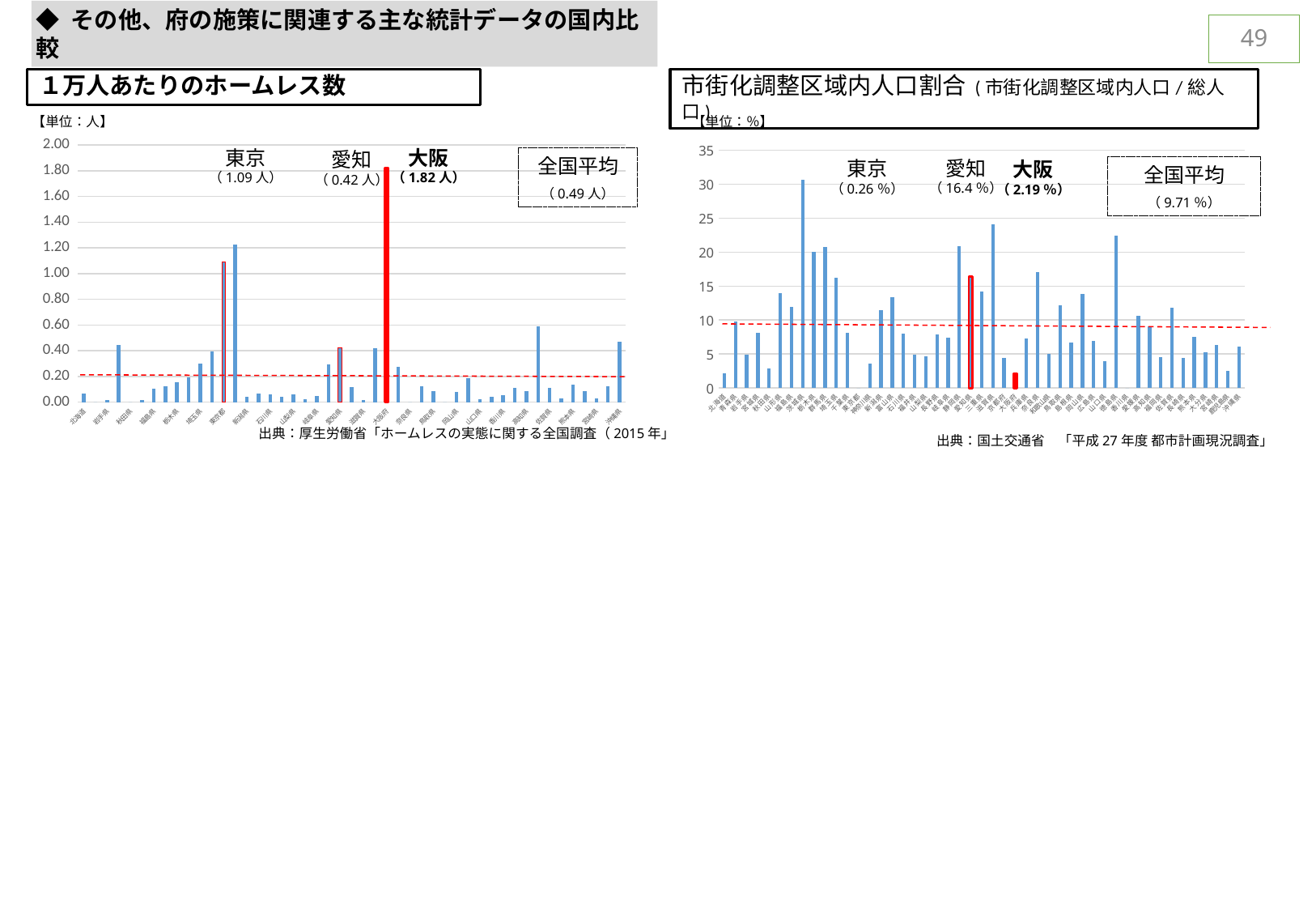
In the left chart (１万人あたりのホームレス数), what is the 全国平均 (national average)? 0.49 人 In the left chart (１万人あたりのホームレス数), what is the value for 東京? 1.09 人 In the left chart (１万人あたりのホームレス数), is the value for 東京 greater or less than 1.00? greater In the right chart (市街化調整区域内人口割合), what is the value for 愛知? 16.4 % In the right chart (市街化調整区域内人口割合), what is the value for 大阪? 2.19 % In the left chart (１万人あたりのホームレス数), what is the value for 大阪? 1.82 人 What kind of chart is the left chart (１万人あたりのホームレス数)? bar chart In the right chart (市街化調整区域内人口割合), what is the 全国平均 (national average)? 9.71 % In the left chart (１万人あたりのホームレス数), which has the larger value, 東京 or 愛知? 東京 In the right chart (市街化調整区域内人口割合), what is the difference between the values for 愛知 and 大阪? 14.21 % In the left chart (１万人あたりのホームレス数), what is the difference between the values for 大阪 and 東京? 0.73 人 In the right chart (市街化調整区域内人口割合), which has the larger value, 愛知 or 大阪? 愛知